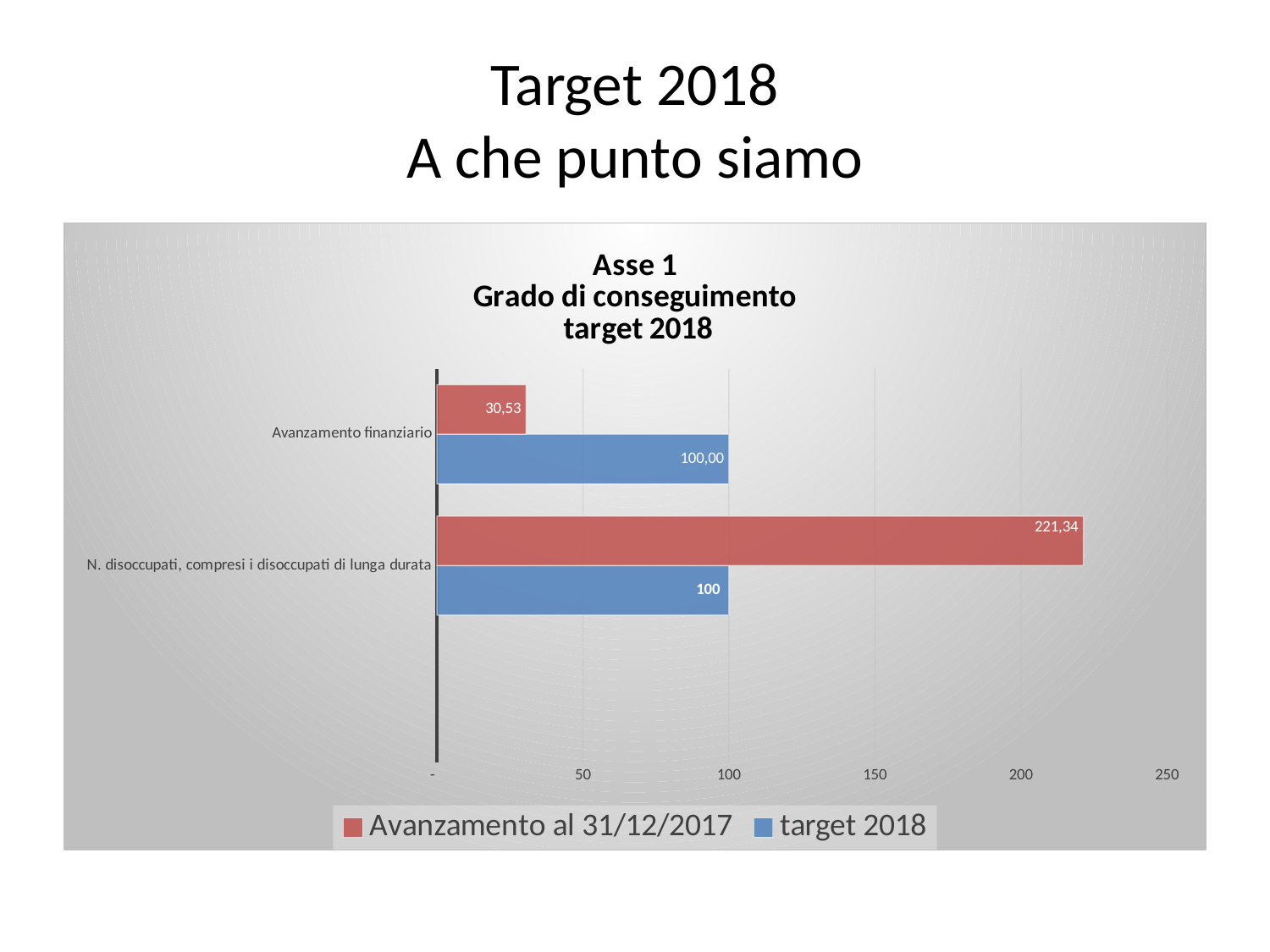
How many categories are shown on the chart? 2 What is the value of "Avanzamento al 31/12/2017" for "Avanzamento finanziario"? 30,53 For "Avanzamento finanziario", which is larger: "Avanzamento al 31/12/2017" or "target 2018"? target 2018 For "N. disoccupati, compresi i disoccupati di lunga durata", which is larger: "Avanzamento al 31/12/2017" or "target 2018"? Avanzamento al 31/12/2017 What is the "target 2018" value for "Avanzamento finanziario"? 100,00 Is the "Avanzamento al 31/12/2017" value for "N. disoccupati, compresi i disoccupati di lunga durata" greater or less than 200? greater What is the "target 2018" value for "N. disoccupati, compresi i disoccupati di lunga durata"? 100 What is the value of "Avanzamento al 31/12/2017" for "N. disoccupati, compresi i disoccupati di lunga durata"? 221,34 What kind of chart is shown on the slide? Bar chart Which category has the lowest "Avanzamento al 31/12/2017" value? Avanzamento finanziario Which category has the highest "Avanzamento al 31/12/2017" value? N. disoccupati, compresi i disoccupati di lunga durata How many series does the legend list? 2